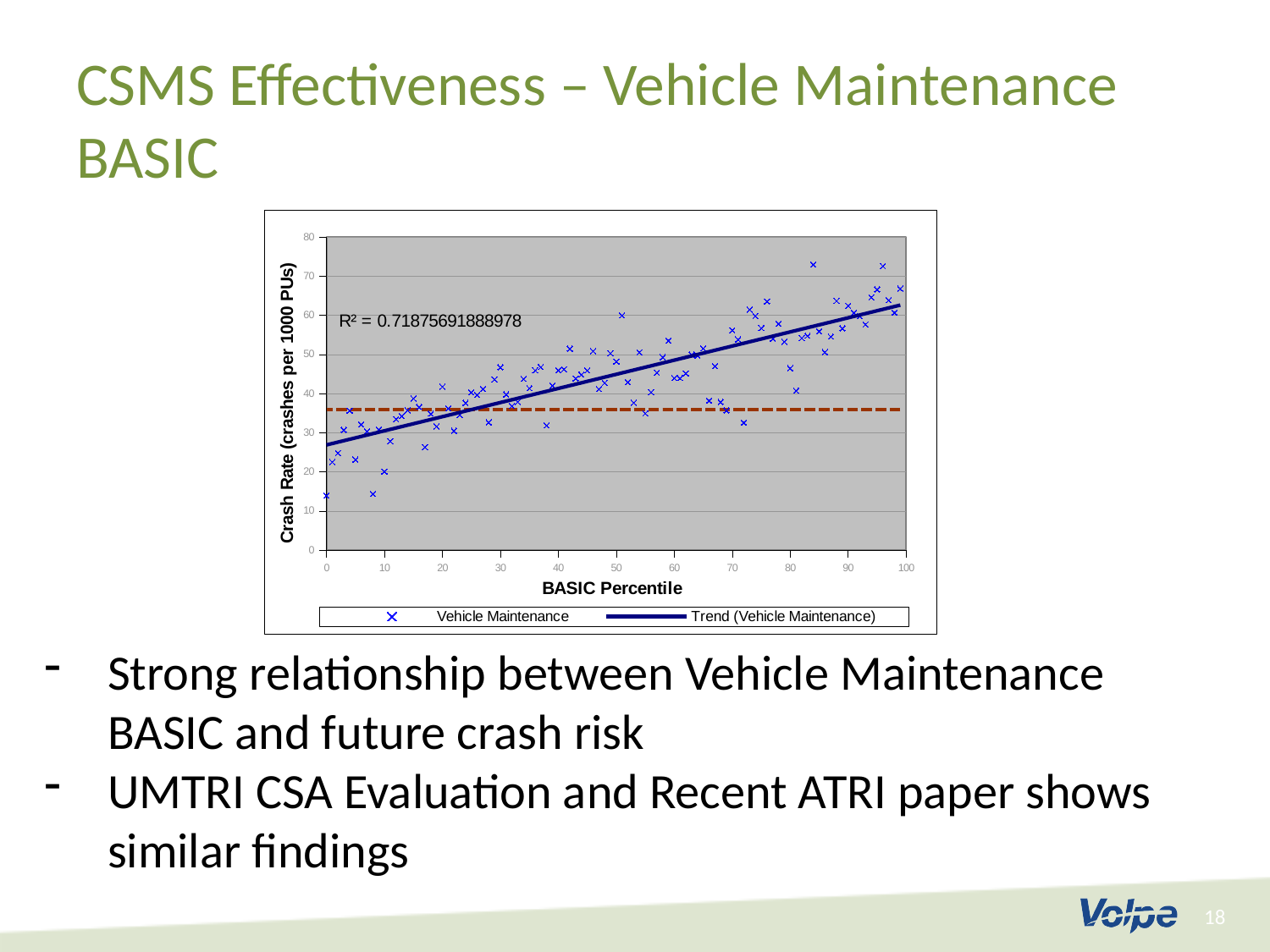
Does the crash rate rise or fall as the BASIC Percentile increases along the x axis? Rises What is the title of the y axis of the chart? Crash Rate (crashes per 1000 PUs) What is the title of the x axis of the chart? BASIC Percentile What is the maximum value shown on the y axis of the chart? 80 What is the R² value printed on the chart? 0.718756918889978 Is the value of the trend line at BASIC Percentile 100 greater or less than 60? greater Is the highest plotted Vehicle Maintenance point greater or less than 70 crashes per 1000 PUs? greater What kind of chart is shown on the slide? Scatter chart Is the dashed horizontal reference line on the chart greater or less than 40 crashes per 1000 PUs? less How many entries does the chart legend list? 2